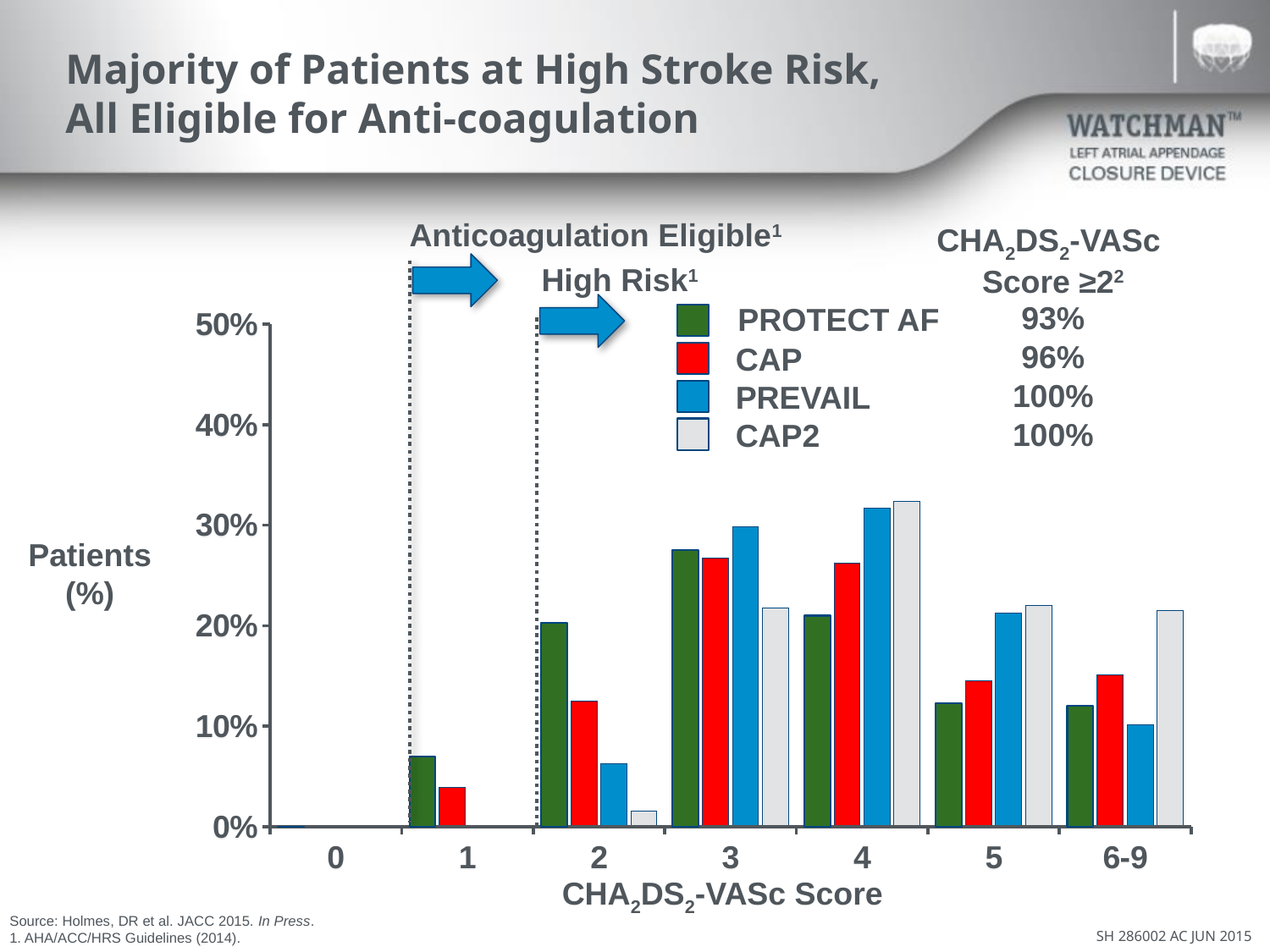
Is the value for PREVAIL at CHA2DS2-VASc score 4 greater or less than 30%? greater Which series is shown in green in the legend? PROTECT AF Is the value for PROTECT AF at CHA2DS2-VASc score 3 greater or less than 30%? less At which CHA2DS2-VASc score is the PROTECT AF bar highest? 3 What colour represents the CAP series? red Is the value for CAP at CHA2DS2-VASc score 2 greater or less than 10%? greater What kind of chart is shown on the slide? bar chart According to the table on the slide, what percentage of PROTECT AF patients had a CHA2DS2-VASc score ≥2? 93% How many series does the legend list? 4 At CHA2DS2-VASc score 6-9, which is larger, the CAP2 bar or the PREVAIL bar? CAP2 How many CHA2DS2-VASc score categories are shown on the x axis? 7